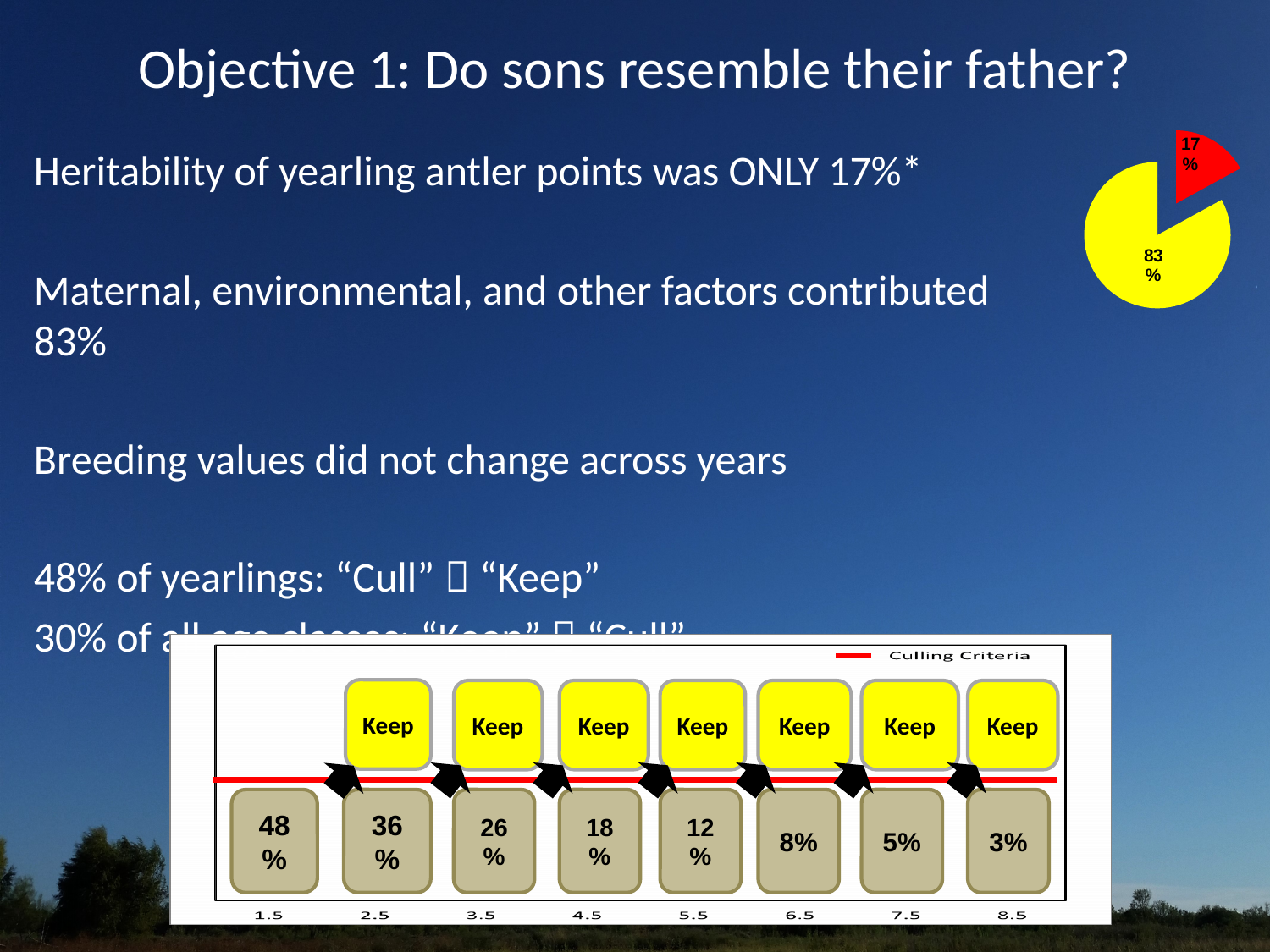
In the chart at the bottom of the slide, what percentage is shown at 1.5? 48% In the pie chart at the top right, what is the value of the yellow slice? 83% In the chart at the bottom of the slide, what percentage is shown at 8.5? 3% In the pie chart at the top right, what is the value of the red slice? 17% In the chart at the bottom of the slide, what does the legend entry for the red line say? Culling Criteria In the pie chart at the top right, which slice is larger, the red one or the yellow one? the yellow one In the chart at the bottom of the slide, what is the difference between the percentages at 1.5 and 2.5? 12% In the chart at the bottom of the slide, what percentage is shown at 4.5? 18% In the chart at the bottom of the slide, do the percentages rise or fall as the x-axis values increase from 1.5 to 8.5? fall How many slices does the pie chart at the top right have? 2 In the chart at the bottom of the slide, which x-axis category has the highest percentage? 1.5 What kind of chart is shown at the top right of the slide? pie chart